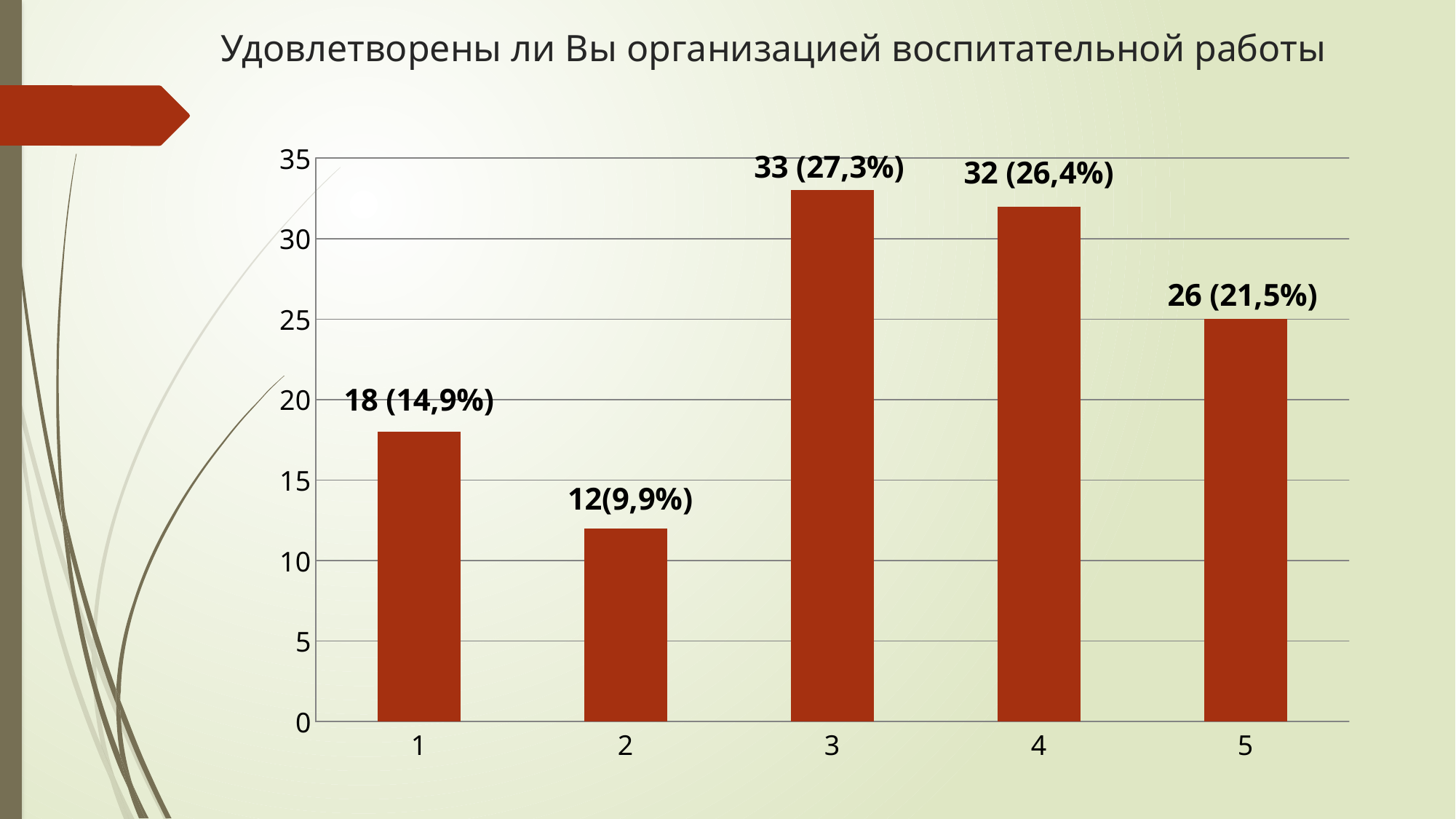
What is the difference between the count for category 3 and the count for category 2? 21 Which category has the highest value? 3 What is the title of the chart? Удовлетворены ли Вы организацией воспитательной работы How many categories are shown on the x axis? 5 Is the value for category 1 greater or less than 20? less What percentage is shown for category 2? 9,9% What is the data label shown for category 1? 18 (14,9%) Which is larger, the value for category 4 or the value for category 5? category 4 What is the data label shown for category 3? 33 (27,3%) What is the data label shown for category 5? 26 (21,5%) What kind of chart is shown on the slide? bar chart Which category has the lowest value? 2